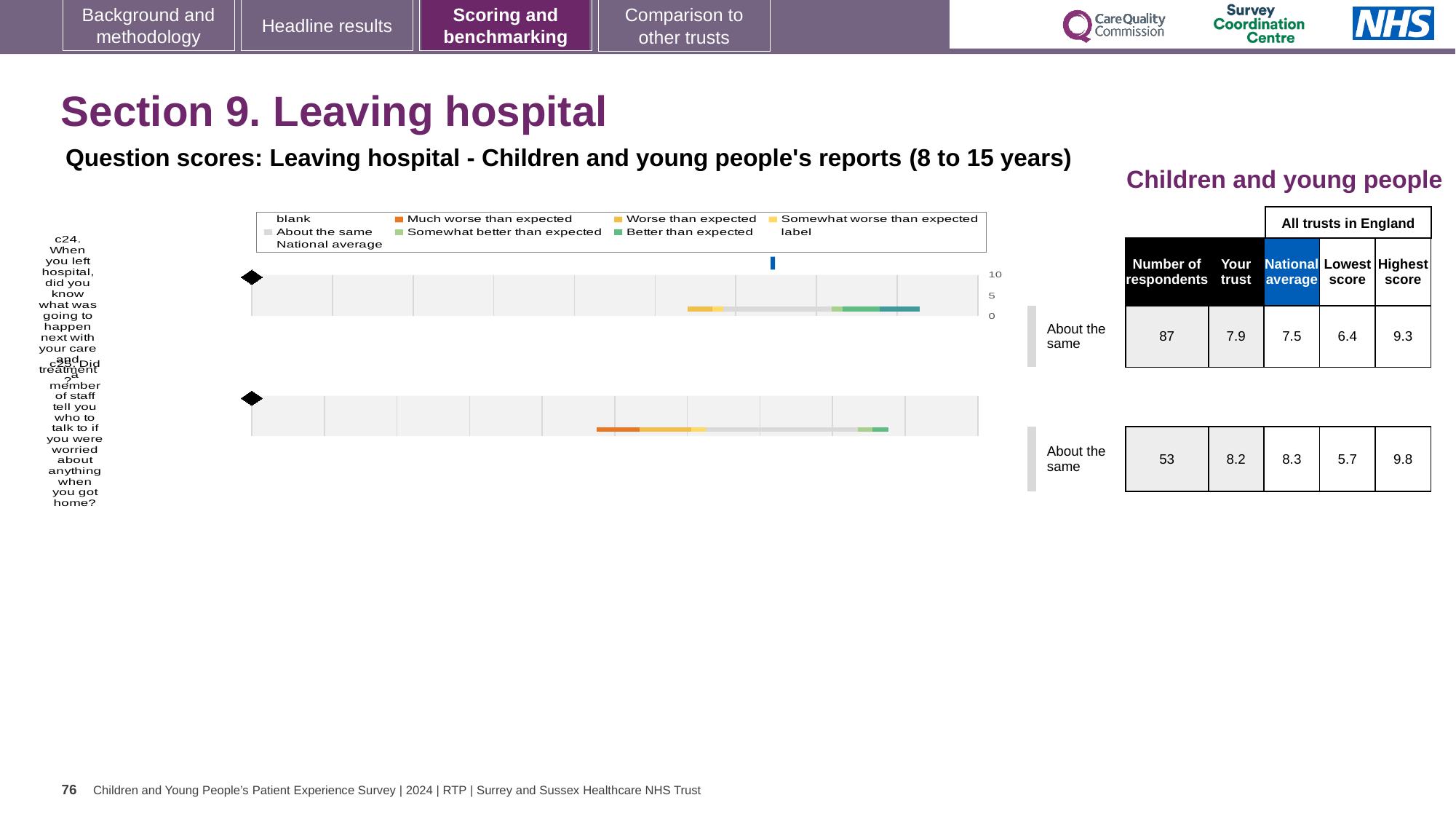
What is the national average score for question c25? 8.3 Which colour in the legend represents 'Much worse than expected'? orange How many respondents answered question c24? 87 What kind of chart is used to show the question scores for c24 and c25? bar chart How many survey questions (rows) are plotted on the slide? 2 What benchmark category label is shown next to the chart for question c25? About the same For question c24, which is larger: the 'Your trust' score or the national average? Your trust What is the lowest score among all trusts in England for question c25? 5.7 For question c25, what is the difference between the highest score and the lowest score? 4.1 What is the 'Your trust' score for question c24? 7.9 What is the highest score among all trusts in England for question c24? 9.3 For question c24, what is the difference between the 'Your trust' score and the national average? 0.4